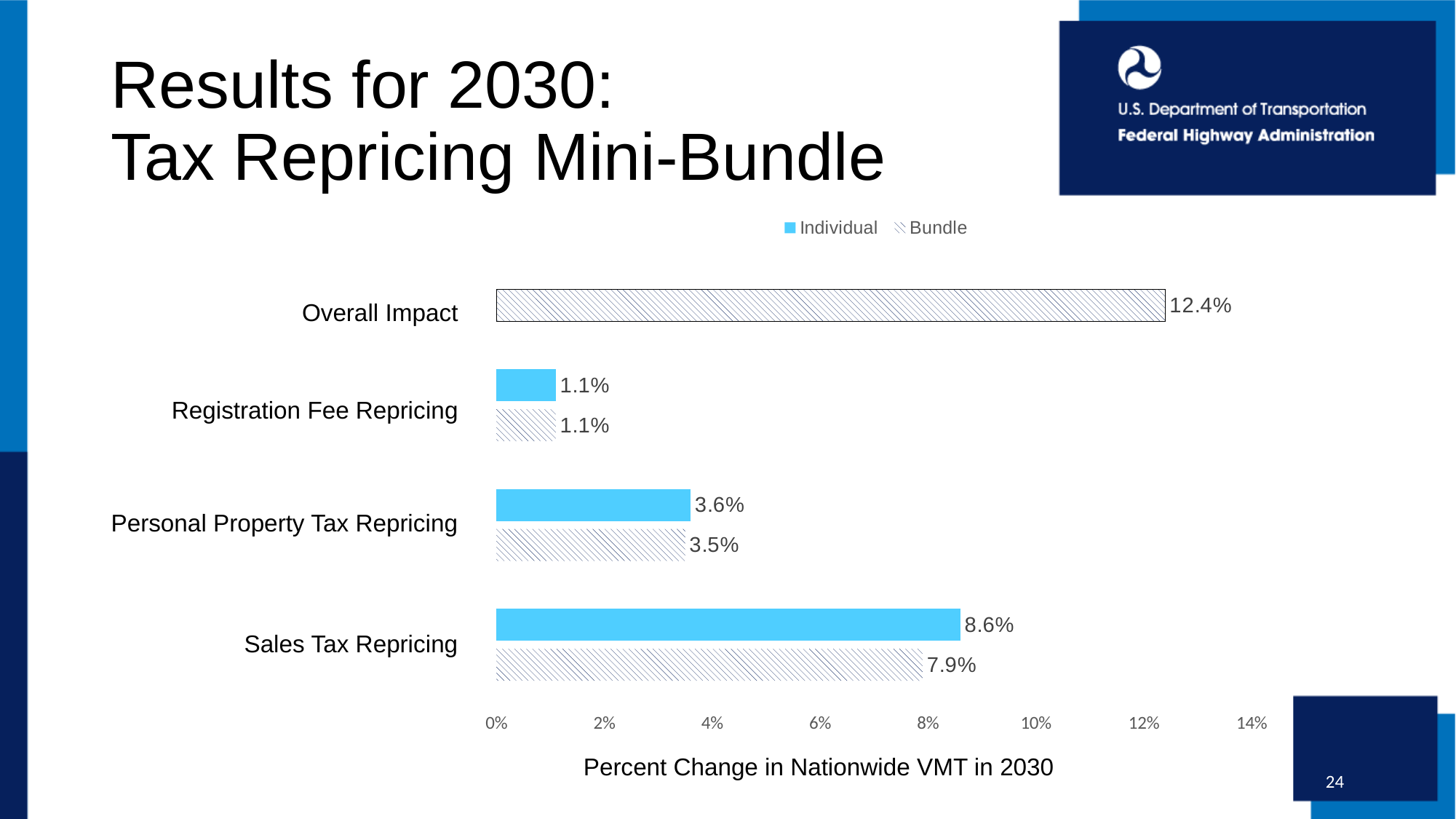
What is the Bundle value for Overall Impact? 12.4% Which category has the highest Individual value? Sales Tax Repricing What is the Bundle value for Personal Property Tax Repricing? 3.5% Which is larger for Personal Property Tax Repricing, the Individual value or the Bundle value? Individual What is the difference between the Individual and Bundle values for Sales Tax Repricing? 0.7% What is the Individual value for Sales Tax Repricing? 8.6% Is the Bundle value for Overall Impact greater or less than 10%? greater How many series does the legend list? 2 What kind of chart is shown on the slide? Bar chart What is the Individual value for Registration Fee Repricing? 1.1% How many categories are shown on the y axis? 4 Which category has the lowest Bundle value? Registration Fee Repricing